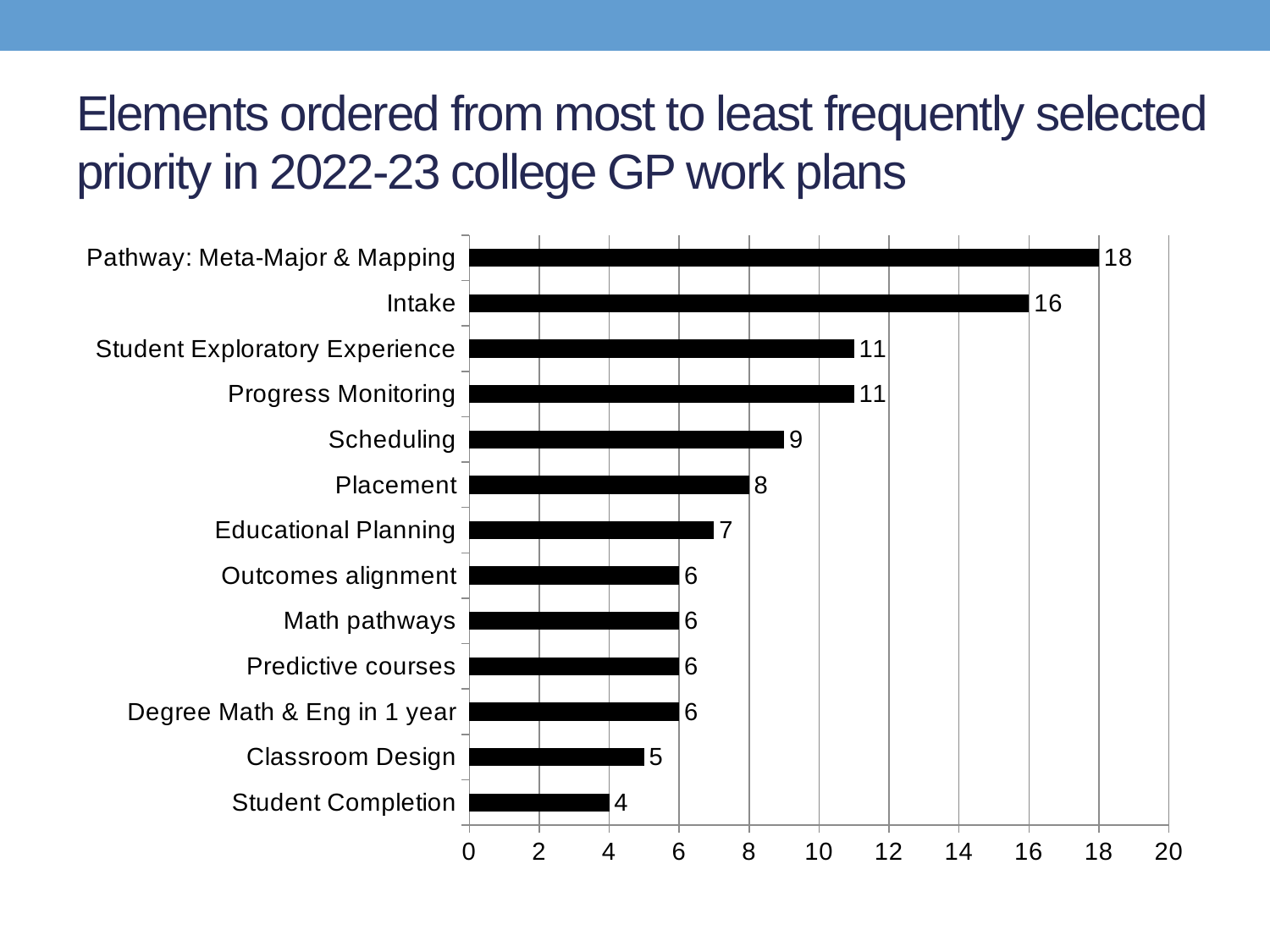
Is the value for Student Exploratory Experience greater or less than 10? greater What is the difference between the values for Placement and Student Completion? 4 How many categories are shown in the chart? 13 What is the difference between the values for Pathway: Meta-Major & Mapping and Intake? 2 Which category has the lowest value? Student Completion What is the value for Scheduling? 9 Which category has the highest value? Pathway: Meta-Major & Mapping What is the value for Progress Monitoring? 11 Which is larger, the value for Educational Planning or the value for Scheduling? Scheduling What kind of chart is shown on the slide? Bar chart What is the value for Classroom Design? 5 What is the value for Intake? 16